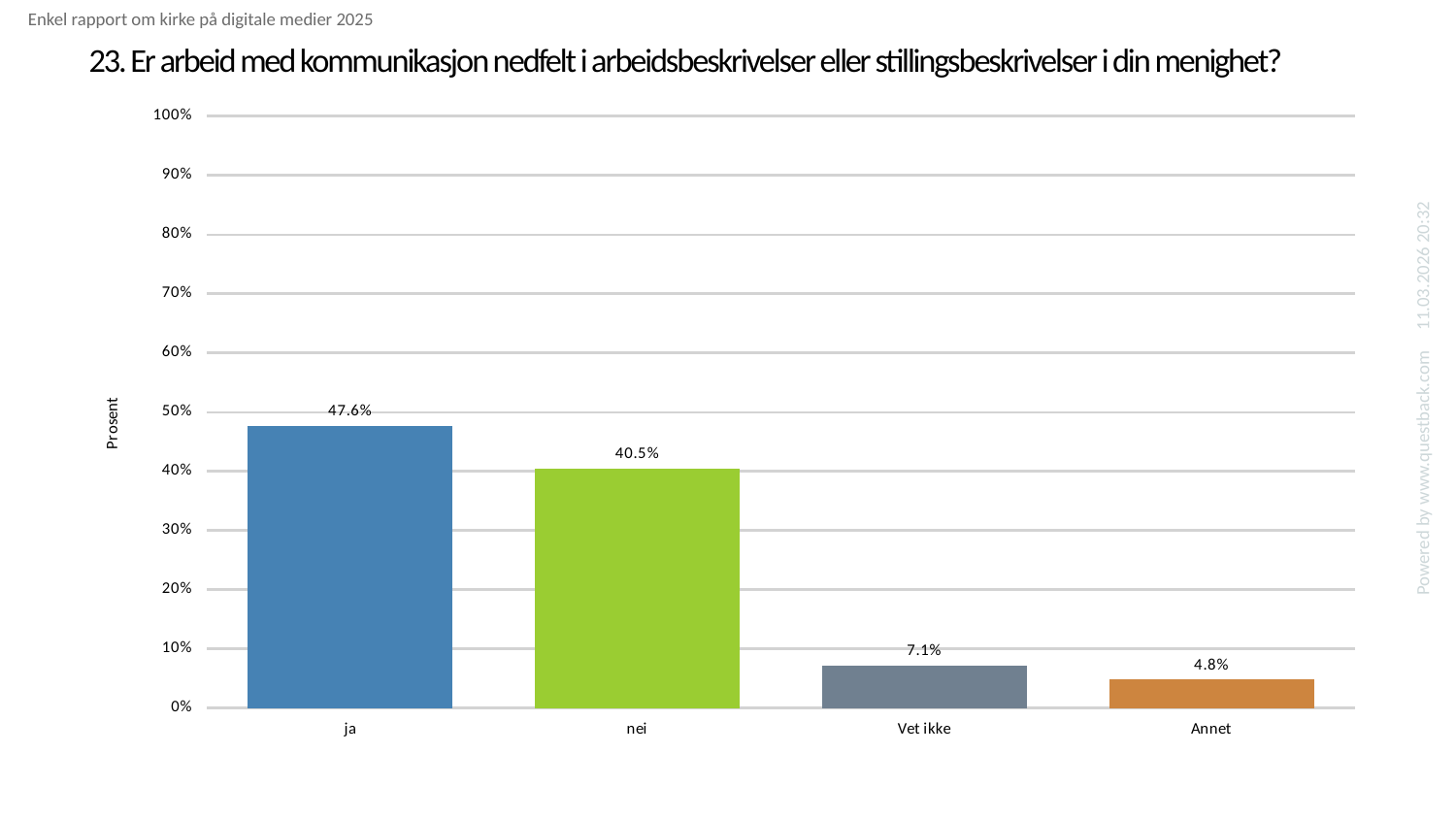
Which category has the highest value? ja Which is larger, the value for "Vet ikke" or the value for "Annet"? Vet ikke What is the value for "nei"? 40.5% What kind of chart is shown on the slide? bar chart What is the difference between the values for "ja" and "nei"? 7.1% What is the label of the y axis? Prosent Is the value for "nei" greater or less than 50%? less How many categories are shown on the x axis? 4 What is the value for "ja"? 47.6% What is the value for "Vet ikke"? 7.1% What is the value for "Annet"? 4.8% Which category has the lowest value? Annet